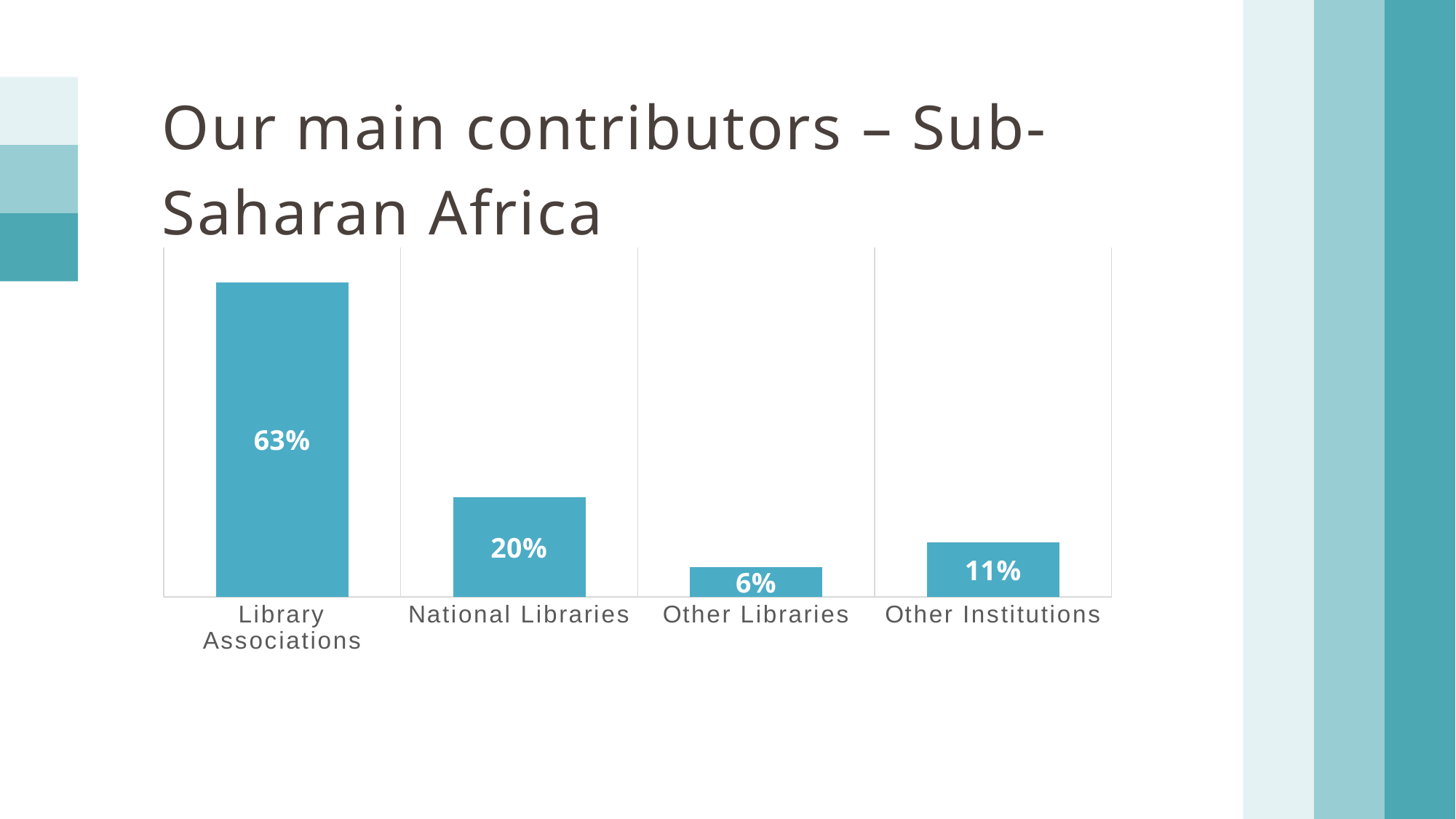
What is the title of the slide containing the chart? Our main contributors – Sub-Saharan Africa What percentage is shown for Library Associations? 63% What percentage is shown for Other Institutions? 11% What is the difference between the values for Library Associations and National Libraries? 43% Which category has the lowest value? Other Libraries What percentage is shown for Other Libraries? 6% What percentage is shown for National Libraries? 20% How many categories are shown in the chart? 4 What kind of chart is shown on the slide? Bar chart Which category has the highest value? Library Associations Which is larger, the value for National Libraries or the value for Other Institutions? National Libraries What is the difference between the values for Other Institutions and Other Libraries? 5%